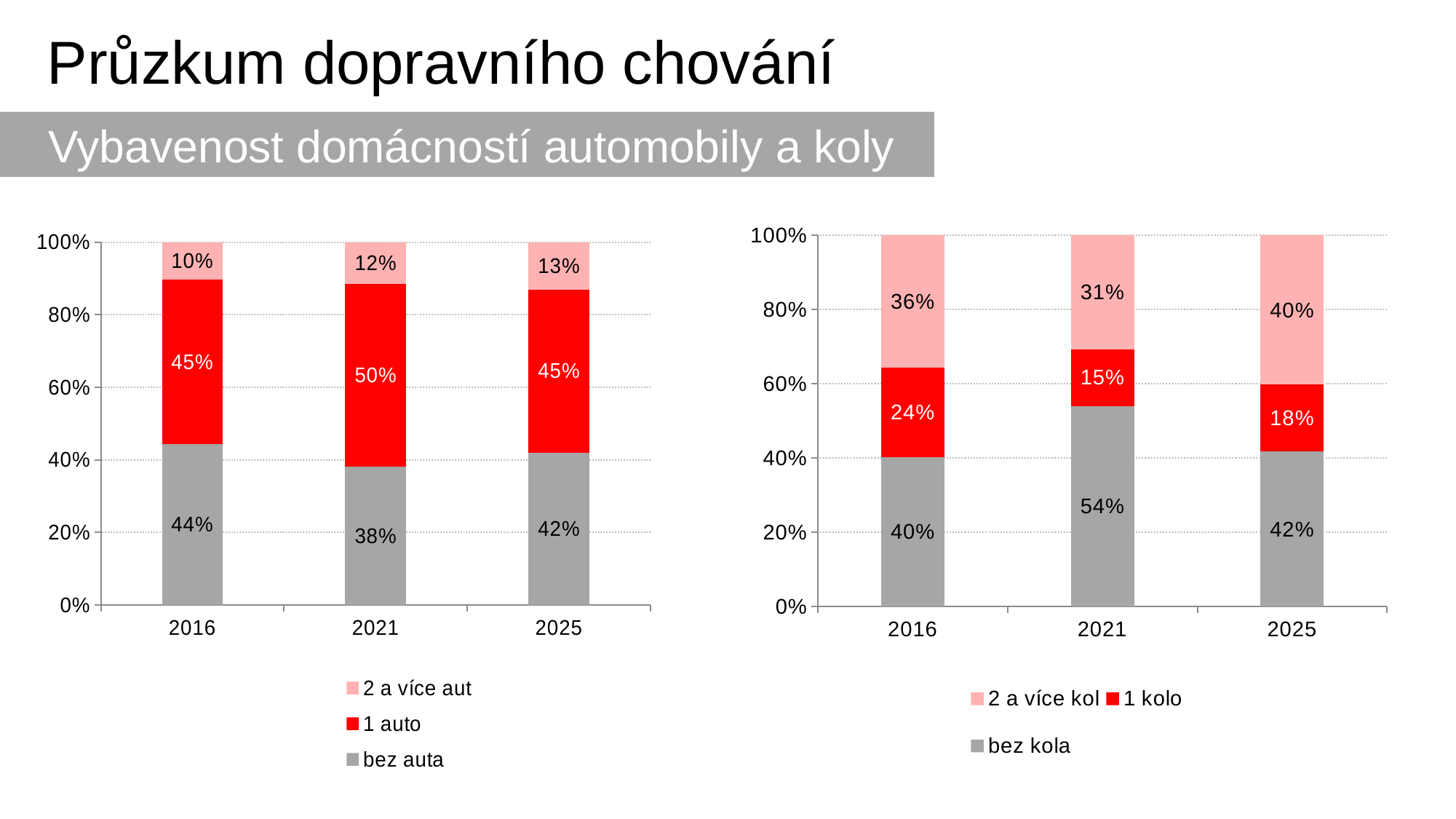
What type of chart is the left chart? Stacked bar chart In the left chart, which is larger: '1 auto' in 2021 or '1 auto' in 2025? 1 auto in 2021 In the left chart, what is the value for 'bez auta' in 2021? 38% In the right chart, what is the difference between the 'bez kola' values for 2021 and 2016? 14% How many series does the legend of the left chart list? 3 In the right chart, what is the value for '2 a více kol' in 2025? 40% How many years are shown on the x axis of the right chart? 3 In the left chart, what is the value for '1 auto' in 2021? 50% In the left chart, does the value for '2 a více aut' rise or fall from 2016 to 2025? Rise In the left chart, which year has the highest value for '2 a více aut'? 2025 In the right chart, what is the value for 'bez kola' in 2021? 54% In the right chart, which year has the lowest value for '1 kolo'? 2021